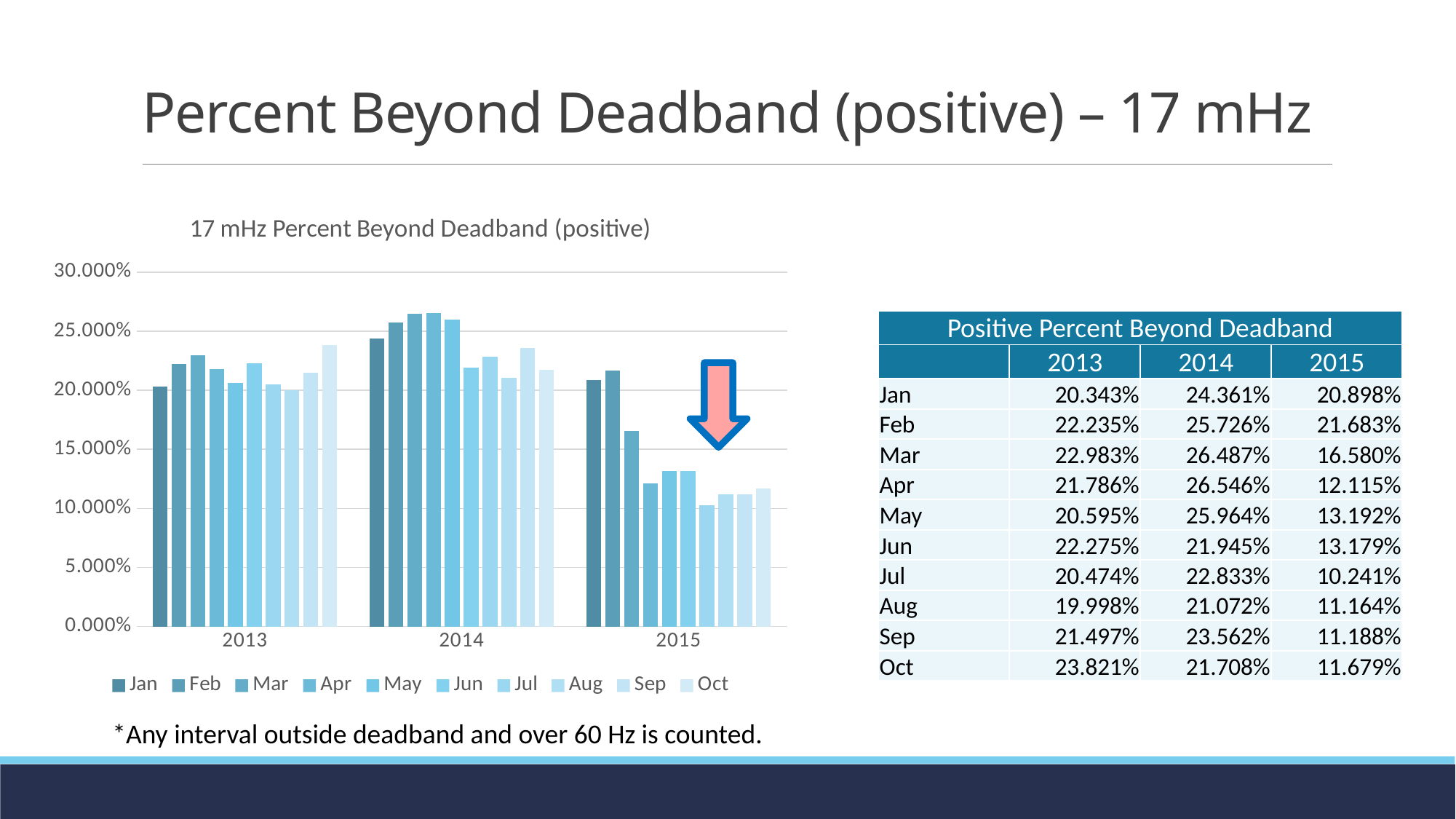
What kind of chart is shown on the slide? bar chart How many series does the chart legend list? 10 Which month has the lowest positive percent beyond deadband in 2015? Jul Which month has the highest positive percent beyond deadband in 2013? Oct Is the value for Sep 2015 greater or less than 15.000%? less What is the title of the chart? 17 mHz Percent Beyond Deadband (positive) According to the slide, what is the positive percent beyond deadband for Jul 2015? 10.241% According to the slide, what is the positive percent beyond deadband for Apr 2014? 26.546% How many year categories are shown on the x axis of the chart? 3 What is the difference between the Jan 2014 value and the Jan 2015 value? 3.463% Which is larger, the value for Mar 2014 or the value for Mar 2015? Mar 2014 Is the value for Jan 2014 greater or less than 20.000%? greater